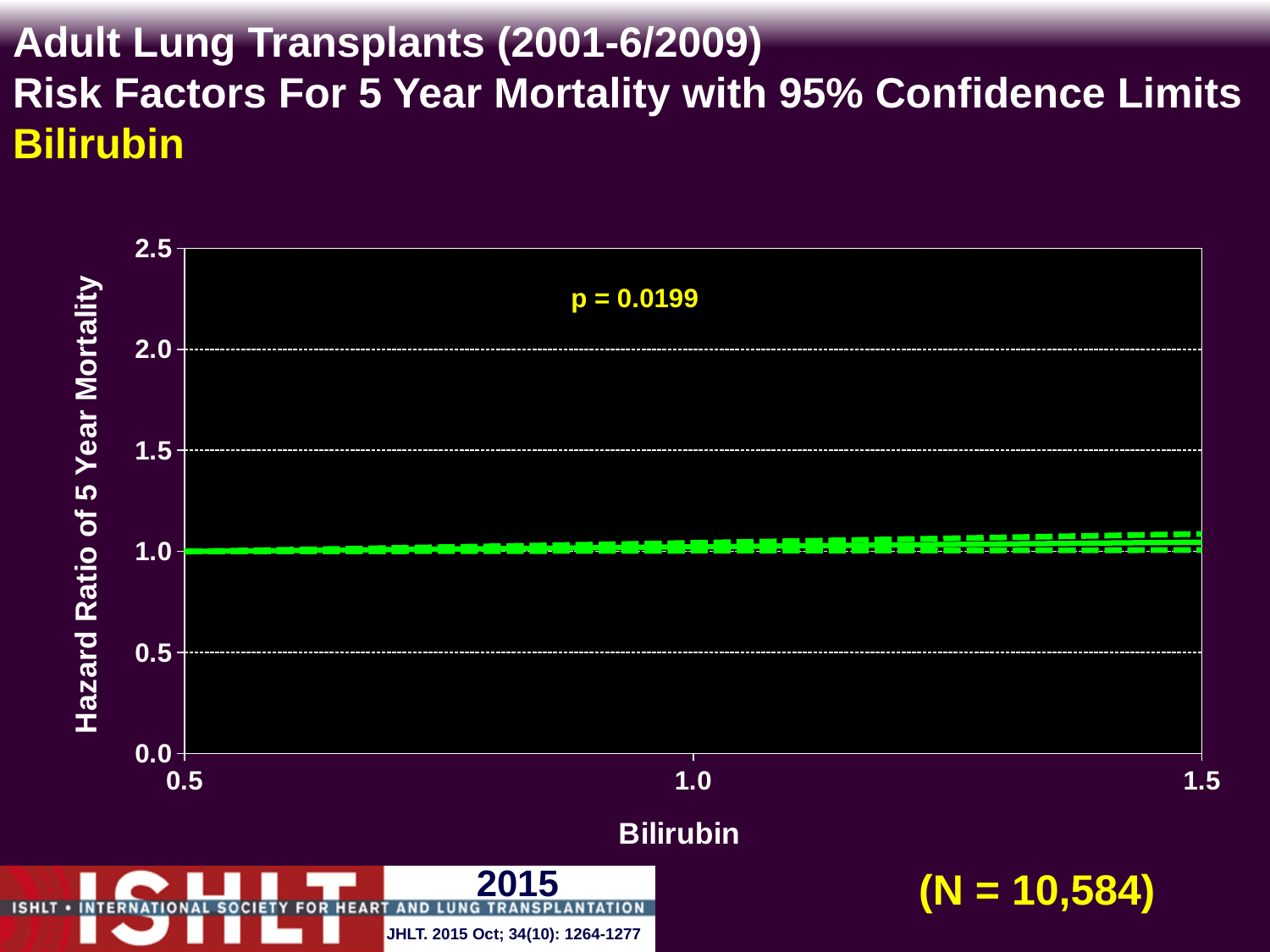
What is the sample size (N) shown on the slide? N = 10,584 What is the label of the y axis? Hazard Ratio of 5 Year Mortality Is the hazard ratio at a bilirubin of 0.5 greater or less than 0.5? greater Is the upper confidence limit at a bilirubin of 1.5 greater or less than 2.0? less Is the hazard ratio at a bilirubin of 1.0 greater or less than 1.5? less What is the highest value shown on the y axis? 2.5 What is the label of the x axis? Bilirubin Does the hazard ratio line rise or fall as bilirubin increases from 0.5 to 1.5? rise What is the p-value printed on the chart? p = 0.0199 What kind of chart is shown on the slide? line chart What is the lowest bilirubin value shown on the x axis? 0.5